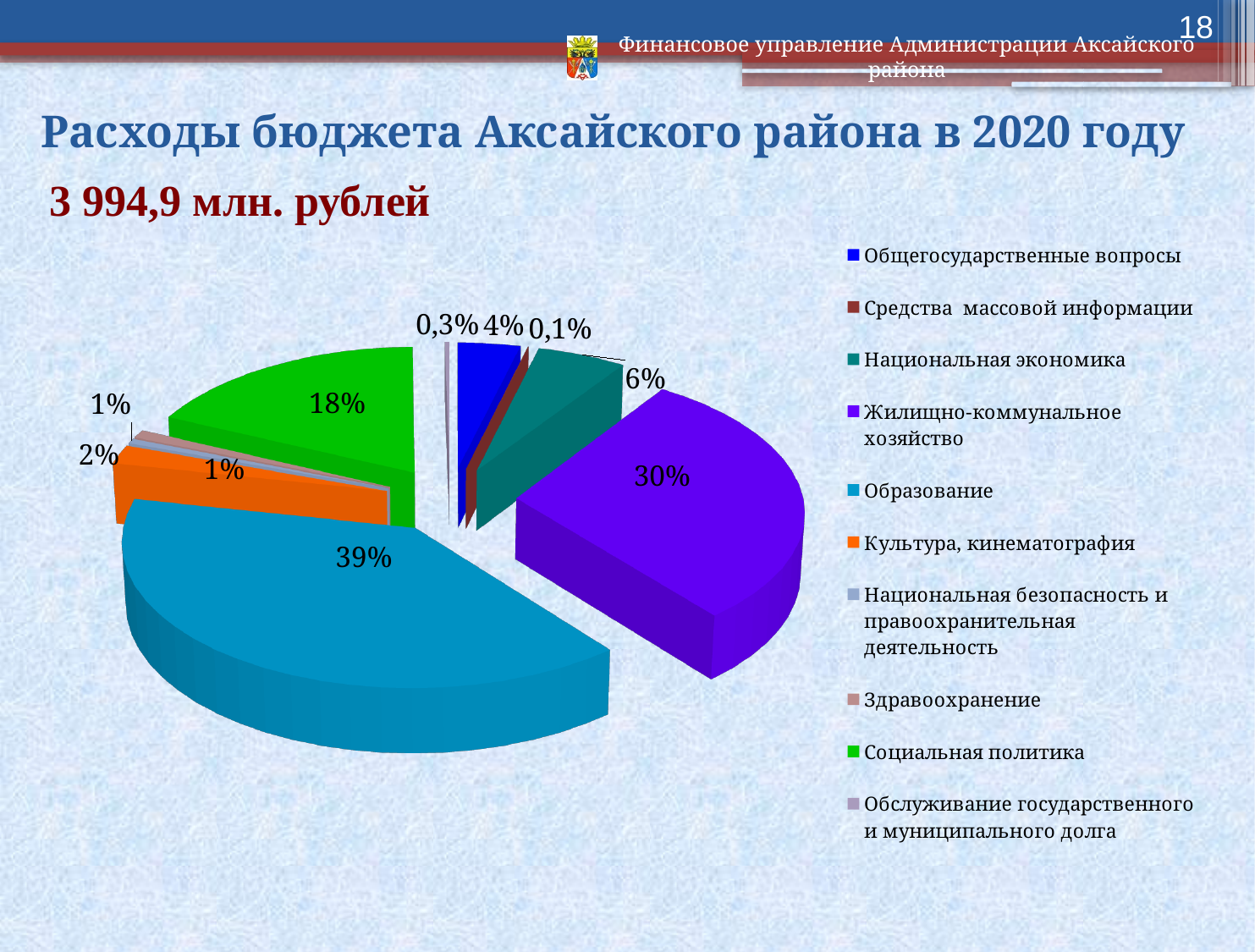
What share of expenditures goes to Общегосударственные вопросы? 4% Which category has the smallest share of the budget expenditures? Средства массовой информации What share of expenditures goes to Средства массовой информации? 0,1% Which is larger: the share for Жилищно-коммунальное хозяйство or for Социальная политика? Жилищно-коммунальное хозяйство What share of expenditures goes to Национальная экономика? 6% What total amount of budget expenditures is stated on the slide? 3 994,9 млн. рублей What share of expenditures goes to Жилищно-коммунальное хозяйство? 30% What kind of chart is shown on the slide? pie chart What share of the 2020 Aksay district budget expenditures goes to Образование? 39% How many categories does the legend list? 10 What share of expenditures goes to Социальная политика? 18% Which category has the largest share of the budget expenditures? Образование